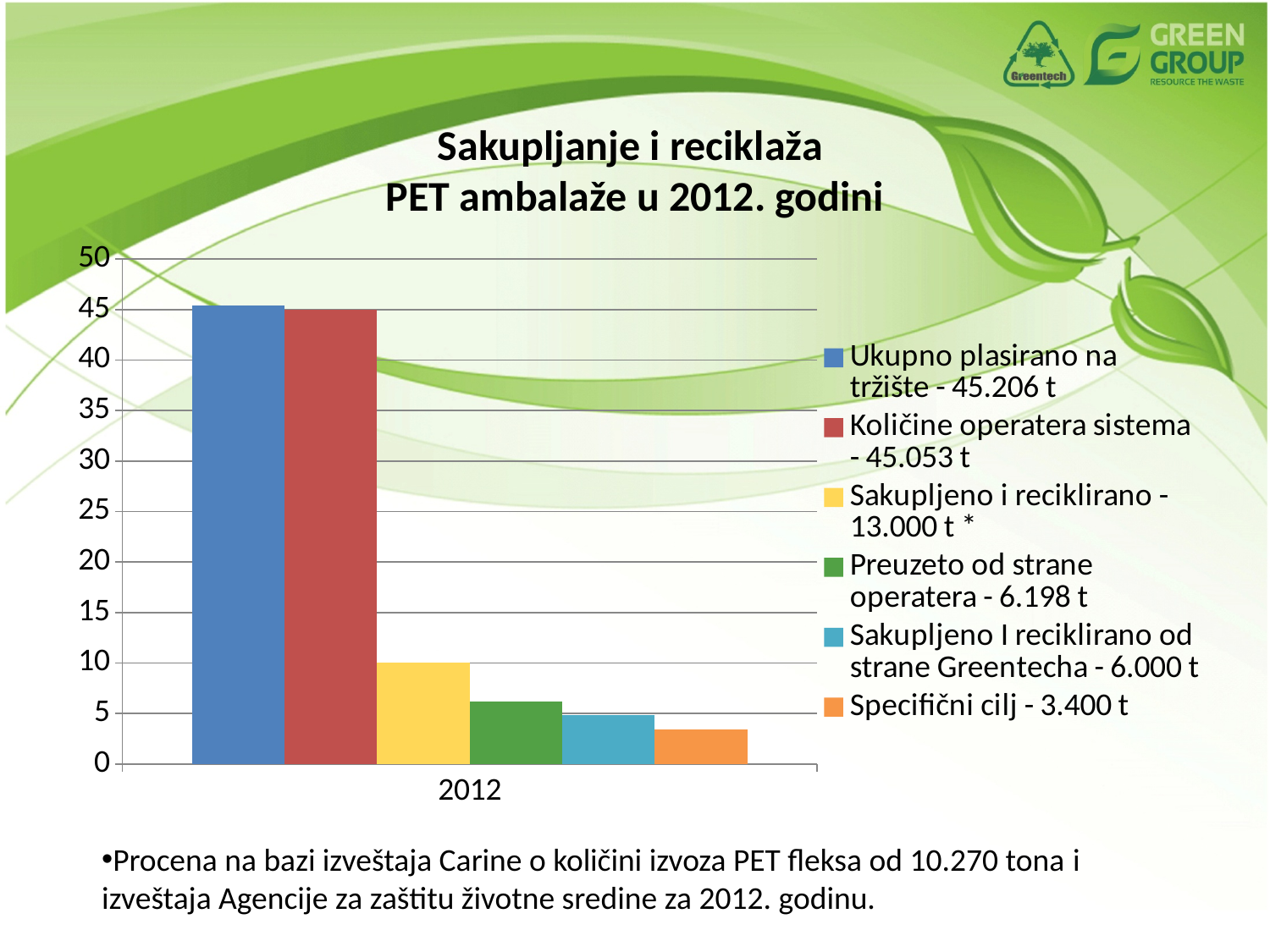
What quantity does the legend give for 'Preuzeto od strane operatera'? 6.198 t Is the bar for 'Sakupljeno i reciklirano' greater or less than 15? less How many categories are shown on the x axis? 1 Is the bar for 'Ukupno plasirano na tržište' greater or less than 40? greater What type of chart is shown on the slide? bar chart How many series does the legend list? 6 What quantity does the legend give for 'Ukupno plasirano na tržište'? 45.206 t Which series has the lowest bar? Specifični cilj - 3.400 t Which category label appears on the x axis? 2012 Which bar is taller: 'Sakupljeno i reciklirano' or 'Preuzeto od strane operatera'? Sakupljeno i reciklirano What is the title of the chart? Sakupljanje i reciklaža PET ambalaže u 2012. godini What quantity does the legend give for 'Specifični cilj'? 3.400 t